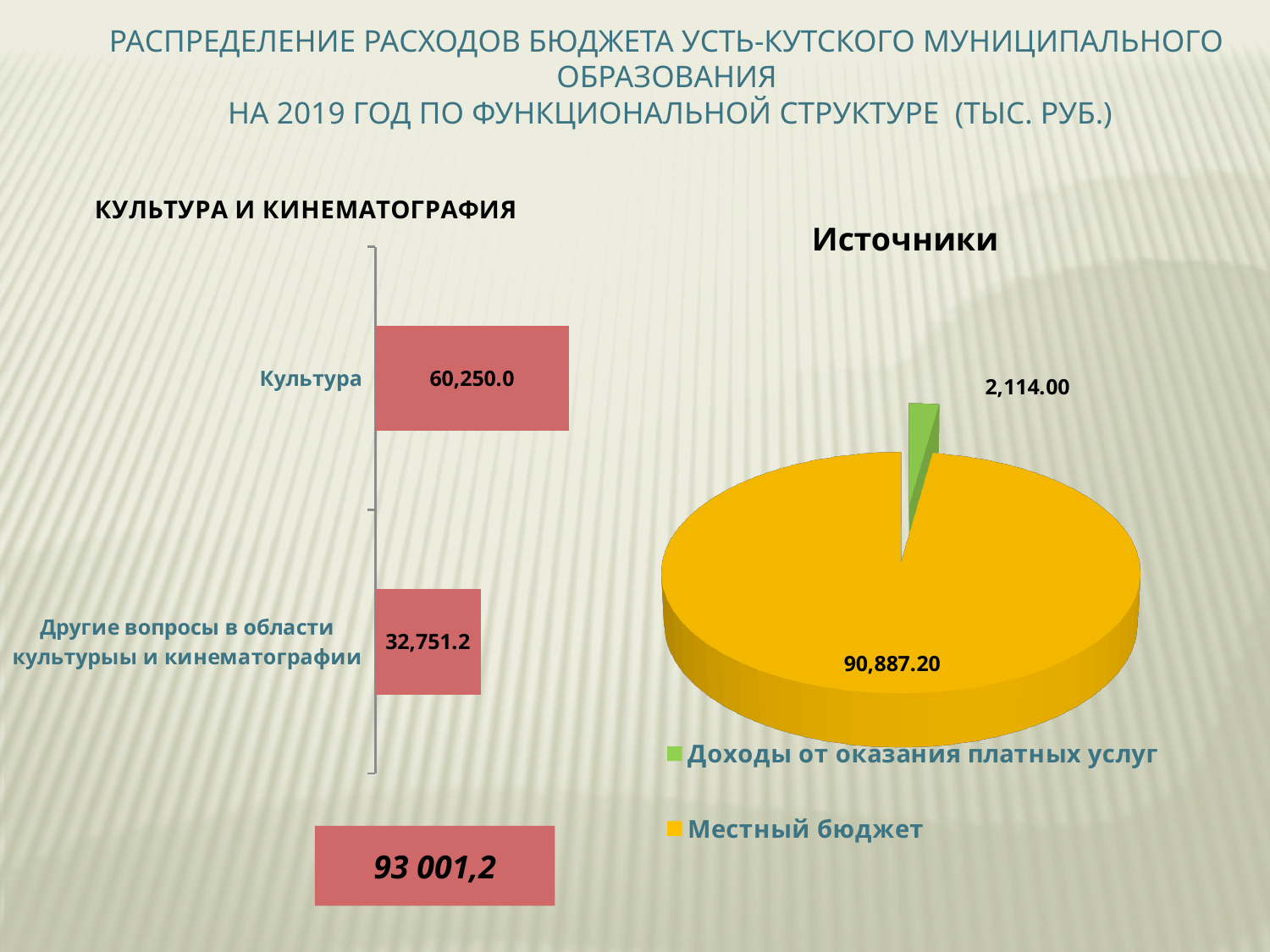
In the chart titled «Источники», what is the value for «Доходы от оказания платных услуг»? 2,114.00 In the chart titled «КУЛЬТУРА И КИНЕМАТОГРАФИЯ», what is the value for «Другие вопросы в области культурыы и кинематографии»? 32,751.2 In the chart titled «КУЛЬТУРА И КИНЕМАТОГРАФИЯ», which category has the highest value? Культура What kind of chart is the chart titled «КУЛЬТУРА И КИНЕМАТОГРАФИЯ»? Bar chart In the chart titled «Источники», what is the value for «Местный бюджет»? 90,887.20 In the chart titled «Источники», which is larger: «Местный бюджет» or «Доходы от оказания платных услуг»? Местный бюджет In the chart titled «КУЛЬТУРА И КИНЕМАТОГРАФИЯ», how many categories are plotted? 2 In the chart titled «КУЛЬТУРА И КИНЕМАТОГРАФИЯ», what is the difference between the value for «Культура» and the value for «Другие вопросы в области культурыы и кинематографии»? 27,498.8 In the chart titled «КУЛЬТУРА И КИНЕМАТОГРАФИЯ», what is the value for «Культура»? 60,250.0 What kind of chart is the chart titled «Источники»? Pie chart In the chart titled «Источники», how many entries does the legend list? 2 In the chart titled «Источники», which slice is the smallest? Доходы от оказания платных услуг